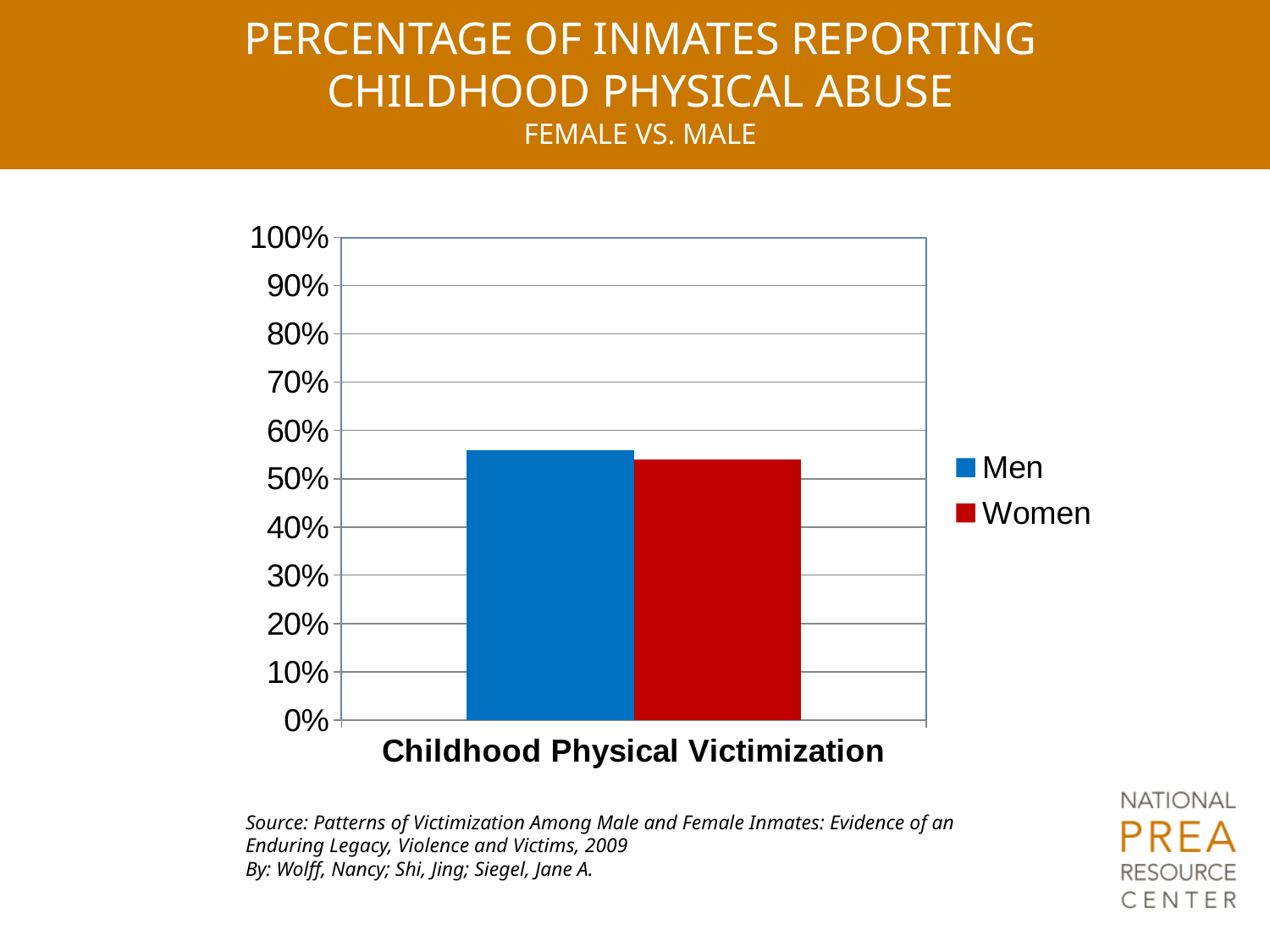
Is the value for Women greater or less than 60%? less Is the value for Women greater or less than 70%? less Is the value for Women greater or less than 50%? greater Which series has the taller bar, Men or Women? Men What kind of chart is shown on the slide? bar chart How many categories are shown on the x axis? 1 What is the label of the category on the x axis? Childhood Physical Victimization Which colour represents the Women series in the legend? red How many series does the legend list? 2